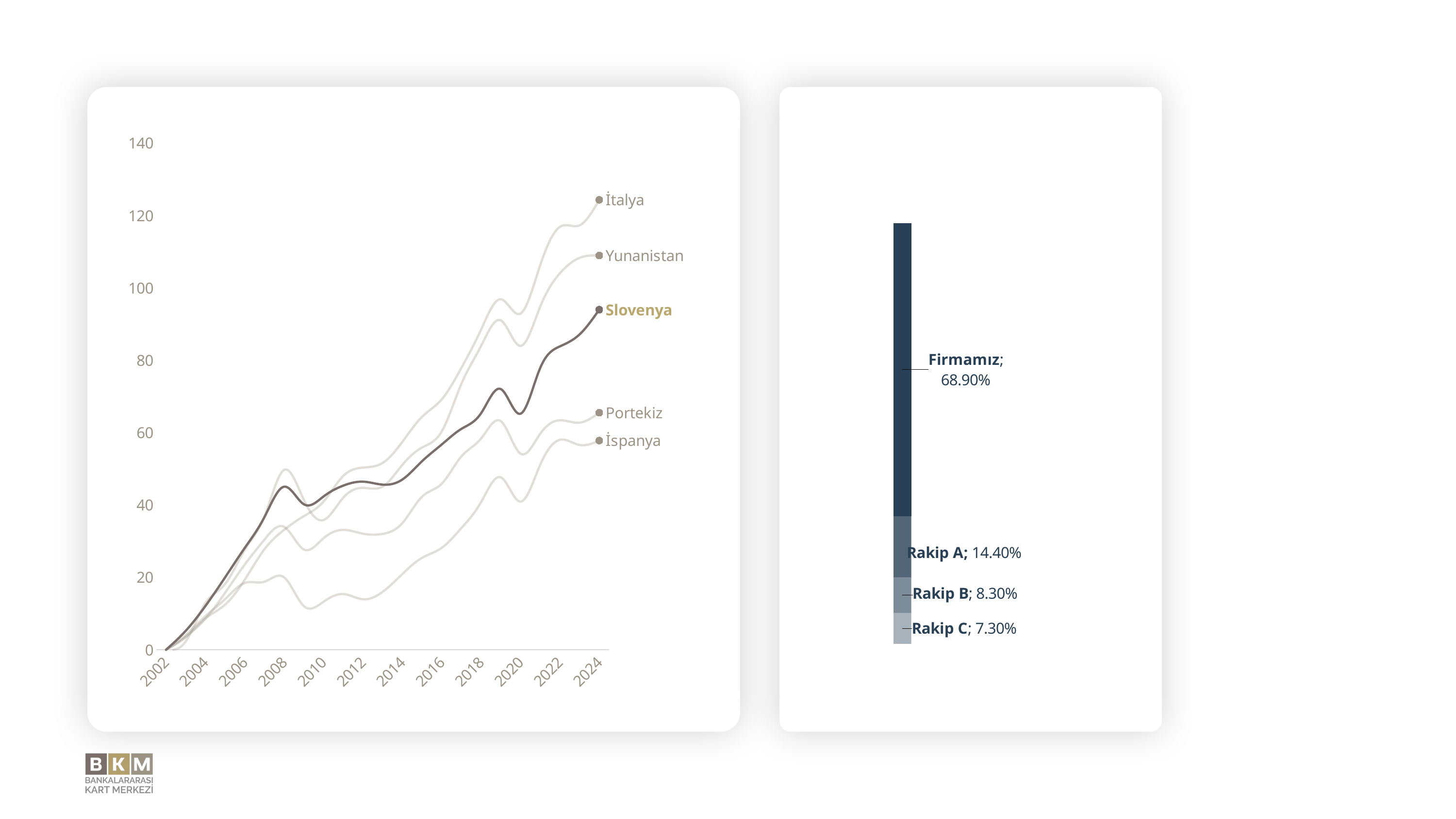
In the line chart on the left, how many countries are plotted? 5 In the line chart on the left, is the value for İtalya in 2024 greater or less than 120? greater In the stacked bar chart on the right, what is the difference between Firmamız and Rakip A? 54.50% In the line chart on the left, does the Slovenya line generally rise or fall from 2002 to 2024? rise In the stacked bar chart on the right, what is the value for Rakip B? 8.30% In the line chart on the left, is the value for Slovenya in 2024 greater or less than 100? less In the line chart on the left, which country has the highest value in 2024? İtalya What type of chart is shown on the left side of the slide? line chart In the line chart on the left, which country has the lowest value in 2024? İspanya In the stacked bar chart on the right, what is the value for Firmamız? 68.90% In the line chart on the left, is the value for İspanya in 2024 greater or less than 60? less In the stacked bar chart on the right, which segment has the smallest value? Rakip C